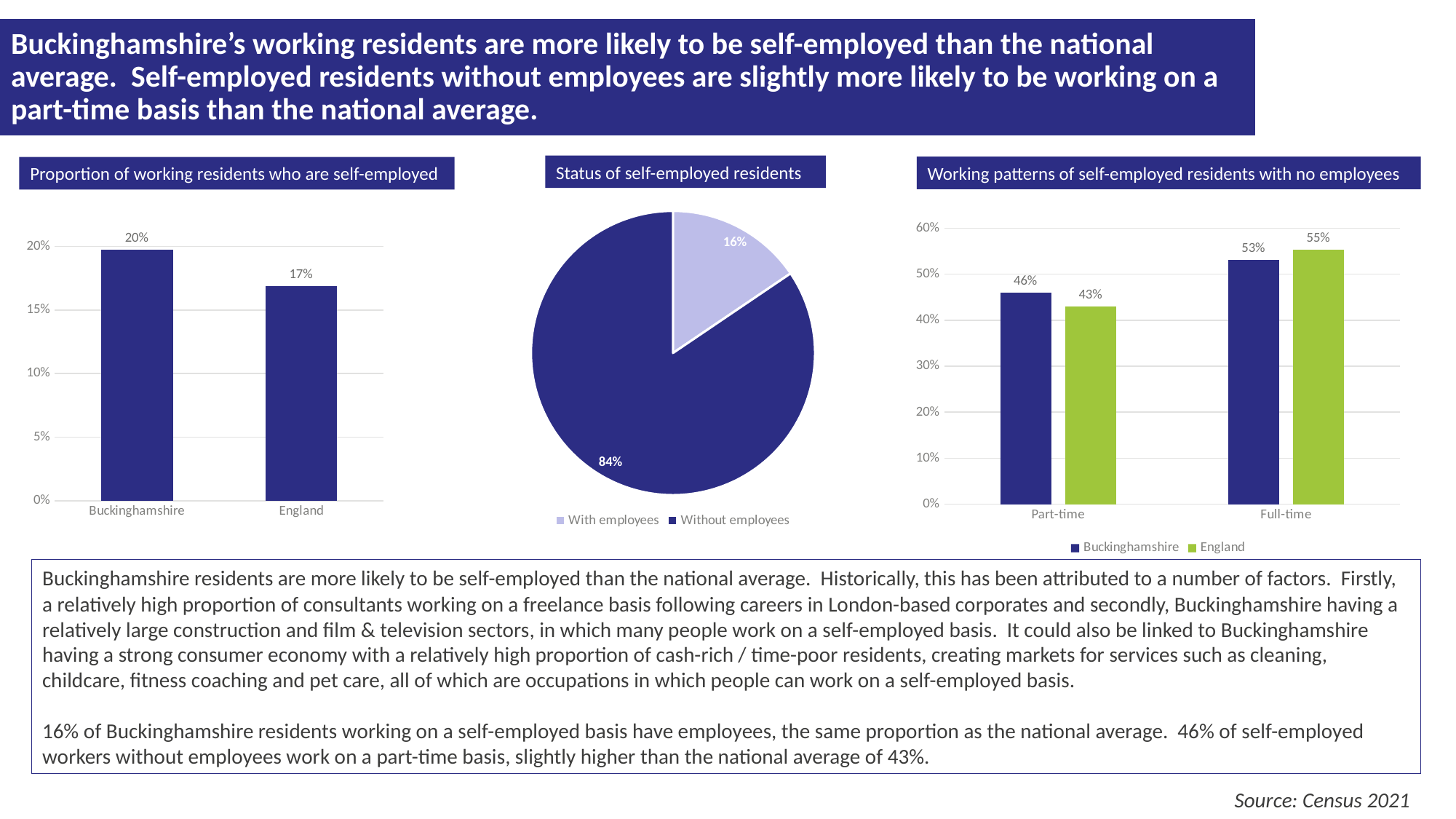
In the 'Proportion of working residents who are self-employed' chart, what is the value for Buckinghamshire? 20% In the 'Proportion of working residents who are self-employed' chart, what is the value for England? 17% How many categories are shown on the x axis of the 'Working patterns of self-employed residents with no employees' chart? 2 What kind of chart is 'Proportion of working residents who are self-employed'? Bar chart In the 'Working patterns of self-employed residents with no employees' chart, what is the difference between the England Full-time and Buckinghamshire Full-time values? 2% In the 'Status of self-employed residents' pie chart, what share of self-employed residents are with employees? 16% In the 'Working patterns of self-employed residents with no employees' chart, which is larger for Part-time: Buckinghamshire or England? Buckinghamshire In the 'Working patterns of self-employed residents with no employees' chart, what is the England value for Full-time? 55% In the 'Status of self-employed residents' pie chart, what share of self-employed residents are without employees? 84% In the 'Working patterns of self-employed residents with no employees' chart, what is the Buckinghamshire value for Part-time? 46% How many series does the legend of the 'Status of self-employed residents' chart list? 2 In the 'Proportion of working residents who are self-employed' chart, what is the difference between the Buckinghamshire and England values? 3%